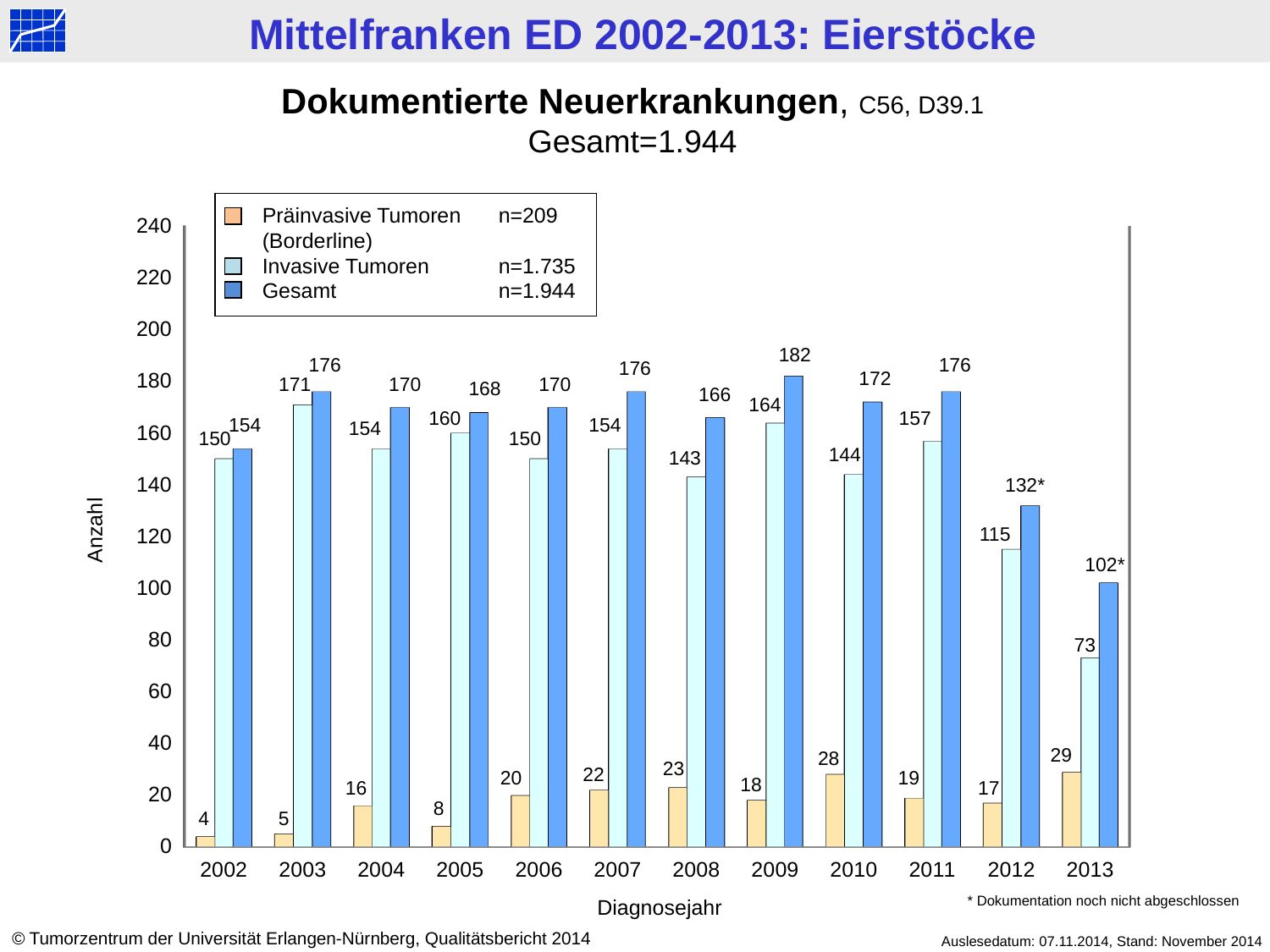
Is the Invasive Tumoren value for 2012 greater or less than 120? less What is the Präinvasive Tumoren (Borderline) value for 2010? 28 Which year has the lowest Präinvasive Tumoren (Borderline) value? 2002 Which is larger, the Invasive Tumoren value for 2009 or for 2011? 2009 What is the n value given in the legend for Invasive Tumoren? n=1.735 What is the difference between the Gesamt values for 2003 and 2002? 22 How many years are shown on the x axis? 12 What kind of chart is shown on the slide? bar chart What is the Invasive Tumoren value for 2005? 160 What is the Gesamt value for 2009? 182 Which year has the highest Gesamt value? 2009 How many series does the legend list? 3